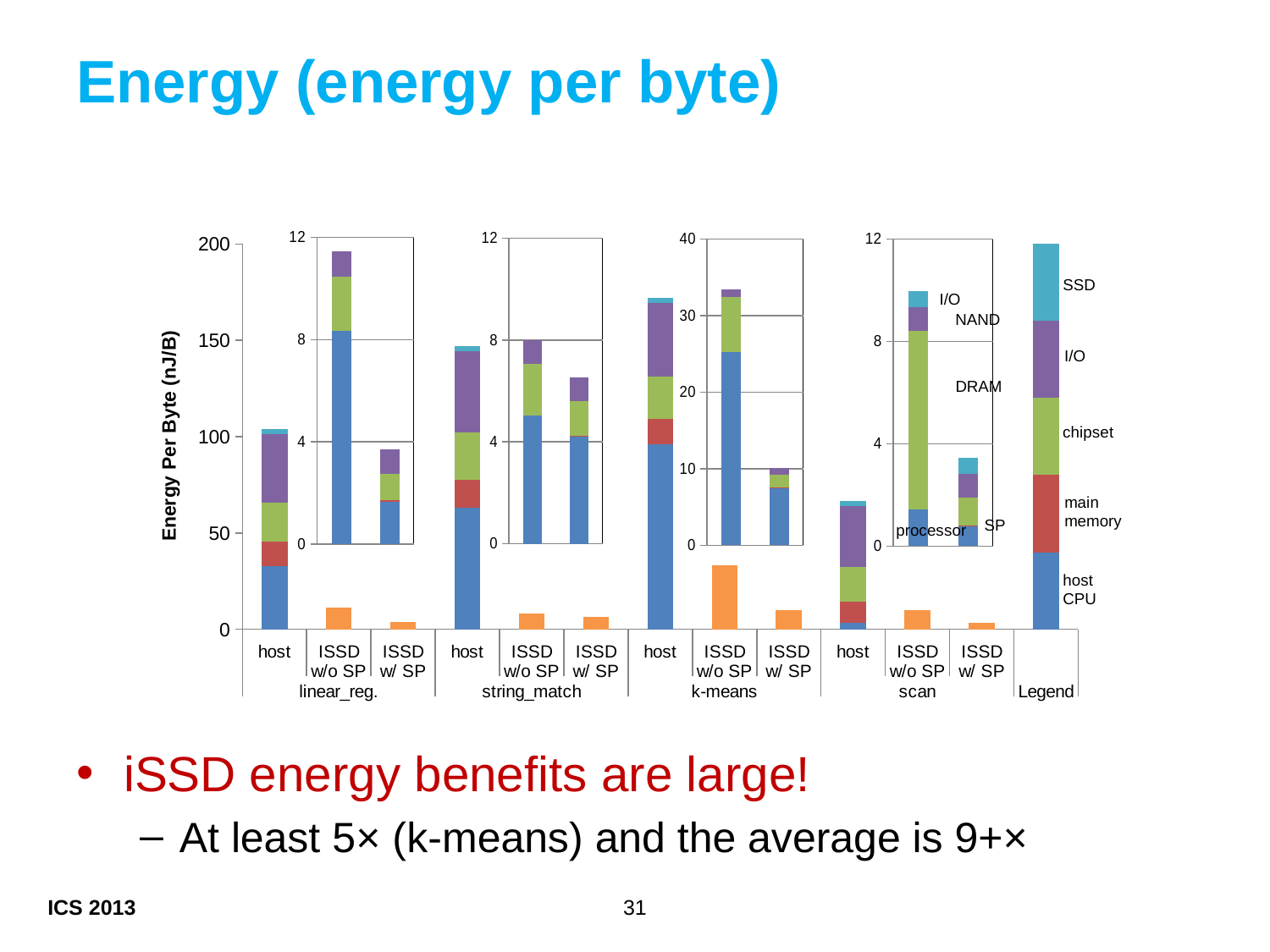
How many workloads (category groups) are shown along the x axis of the main chart? 4 Is the host energy per byte for k-means greater or less than 150 nJ/B? greater Which is larger: the host energy per byte for string_match or for linear_reg.? string_match Is the host energy per byte for string_match greater or less than 100 nJ/B? greater How many components does the Legend bar on the right list for the host stack? 5 What is the maximum value on the y axis of the k-means inset chart? 40 What kind of chart is shown on the slide? Stacked bar chart Is the ISSD w/o SP energy per byte for k-means greater or less than 50 nJ/B? less Which workload has the highest host energy per byte? k-means What is the y-axis title of the main chart? Energy Per Byte (nJ/B) Which workload has the lowest host energy per byte? scan